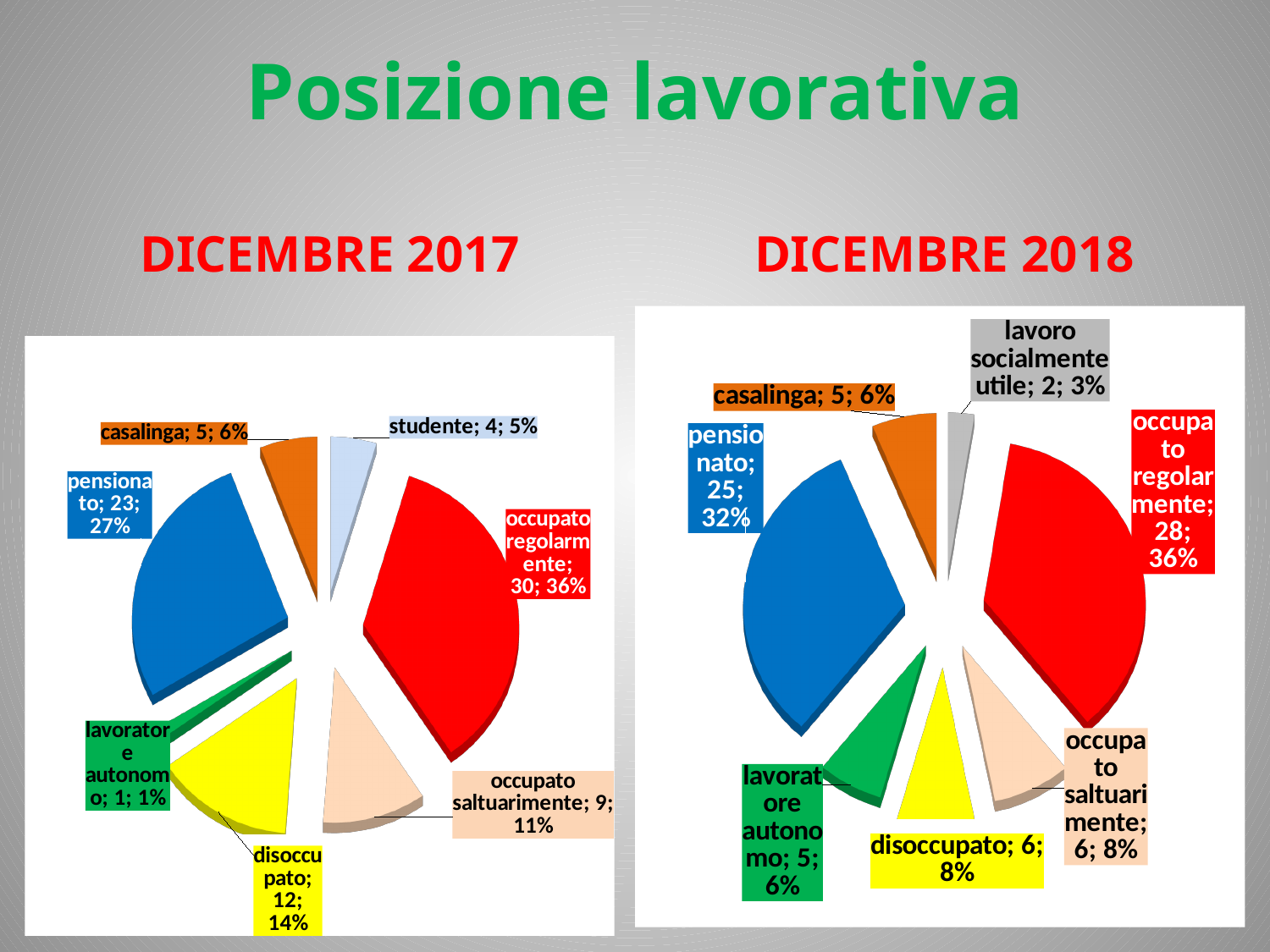
Which is larger: the count for pensionato in DICEMBRE 2017 or in DICEMBRE 2018? DICEMBRE 2018 In the DICEMBRE 2017 chart, how many categories are shown? 7 What is the title of the slide? Posizione lavorativa In the DICEMBRE 2017 chart, what is the value for pensionato? 23; 27% In the DICEMBRE 2018 chart, which category has the smallest slice? lavoro socialmente utile In the DICEMBRE 2017 chart, what share of the pie is disoccupato? 14% In the DICEMBRE 2018 chart, what is the difference in count between occupato regolarmente and pensionato? 3 In the DICEMBRE 2018 chart, what is the value for lavoro socialmente utile? 2; 3% In the DICEMBRE 2017 chart, which category has the largest slice? occupato regolarmente What type of chart is used for DICEMBRE 2017? pie chart In the DICEMBRE 2018 chart, what share of the pie is pensionato? 32% In the DICEMBRE 2017 chart, which category has the smallest slice? lavoratore autonomo